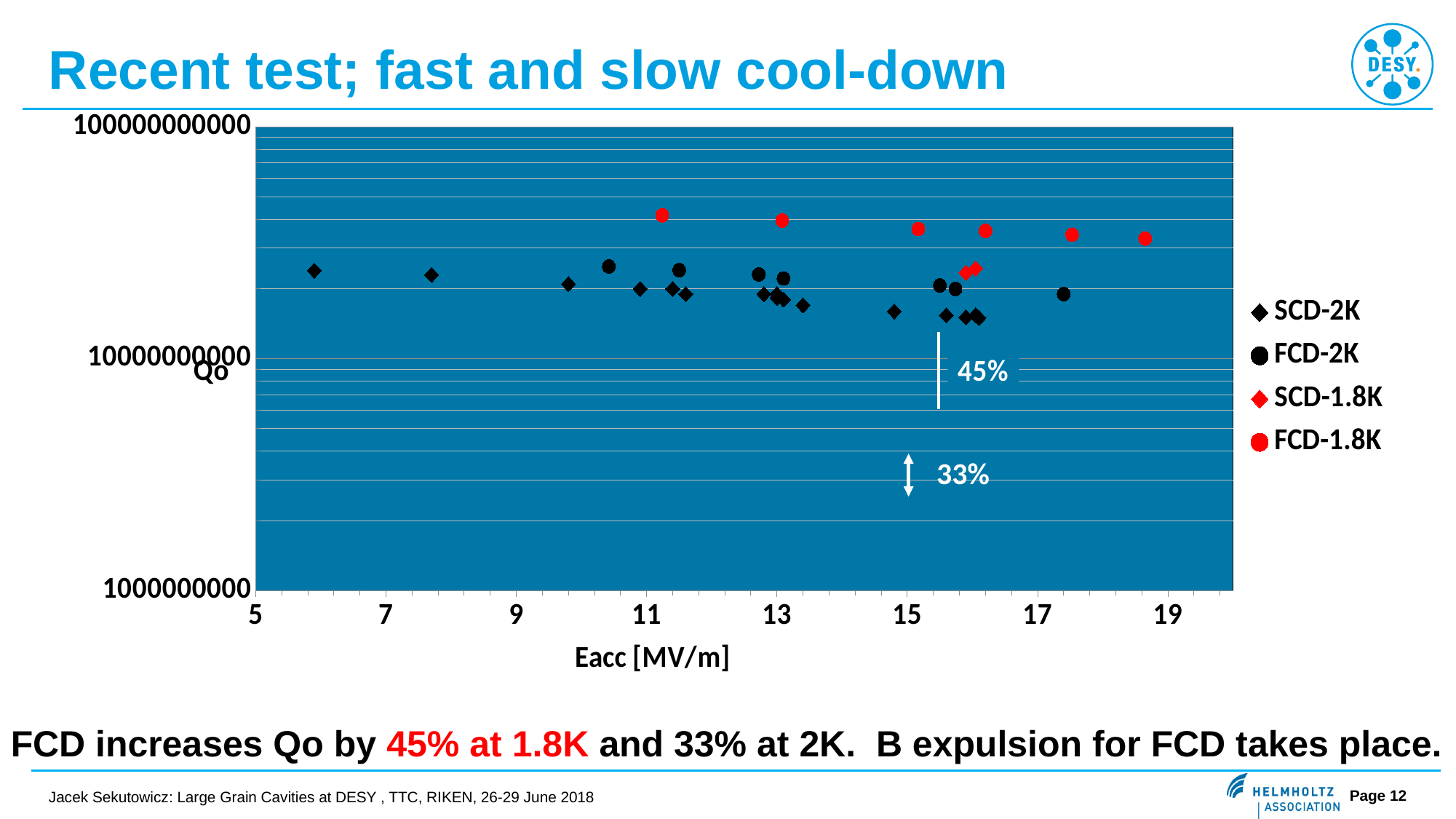
What kind of chart is shown on the slide? scatter chart How many series does the legend list? 4 Is the Qo value of the FCD-1.8K point near 11 MV/m greater or less than 10000000000? greater What is the label of the x axis? Eacc [MV/m] Which series has the lowest Qo values on the chart? SCD-2K Is the Qo value of the SCD-2K point near 6 MV/m greater or less than 100000000000? less What percentage increase is annotated on the chart for the 1.8K data? 45% How many SCD-1.8K points are plotted on the chart? 2 How many FCD-1.8K points are plotted on the chart? 6 Which series has the highest Qo values on the chart? FCD-1.8K Which series is plotted with red circles? FCD-1.8K Which series has higher Qo values, FCD-1.8K or SCD-2K? FCD-1.8K